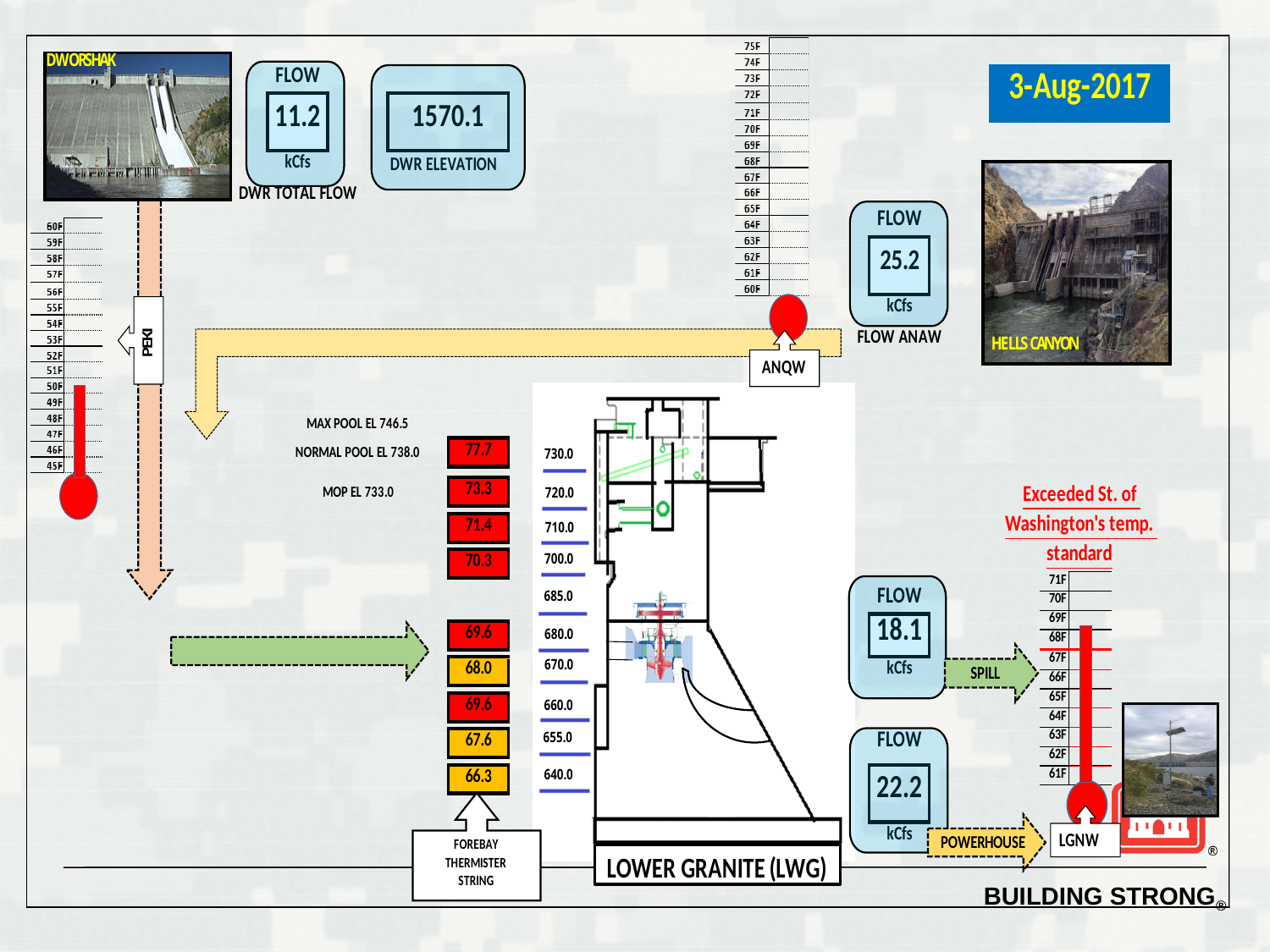
What is the flow value shown for FLOW ANAW? 25.2 kCfs How many temperature readings are shown in the forebay thermistor string? 9 What is the lowest reading in the forebay thermistor string? 66.3 What is the difference between the top (77.7) and bottom (66.3) readings of the forebay thermistor string? 11.4 Which is larger at Lower Granite, the spill flow or the powerhouse flow? Powerhouse flow What is the DWR total flow value shown for Dworshak? 11.2 kCfs What is the combined total of the spill flow and powerhouse flow at Lower Granite? 40.3 kCfs On the LGNW thermometer, is the temperature greater or less than 65F? greater What is the spill flow value shown for Lower Granite? 18.1 kCfs What is the powerhouse flow value shown for Lower Granite? 22.2 kCfs What is the highest reading in the forebay thermistor string? 77.7 What is the DWR elevation shown on the slide? 1570.1